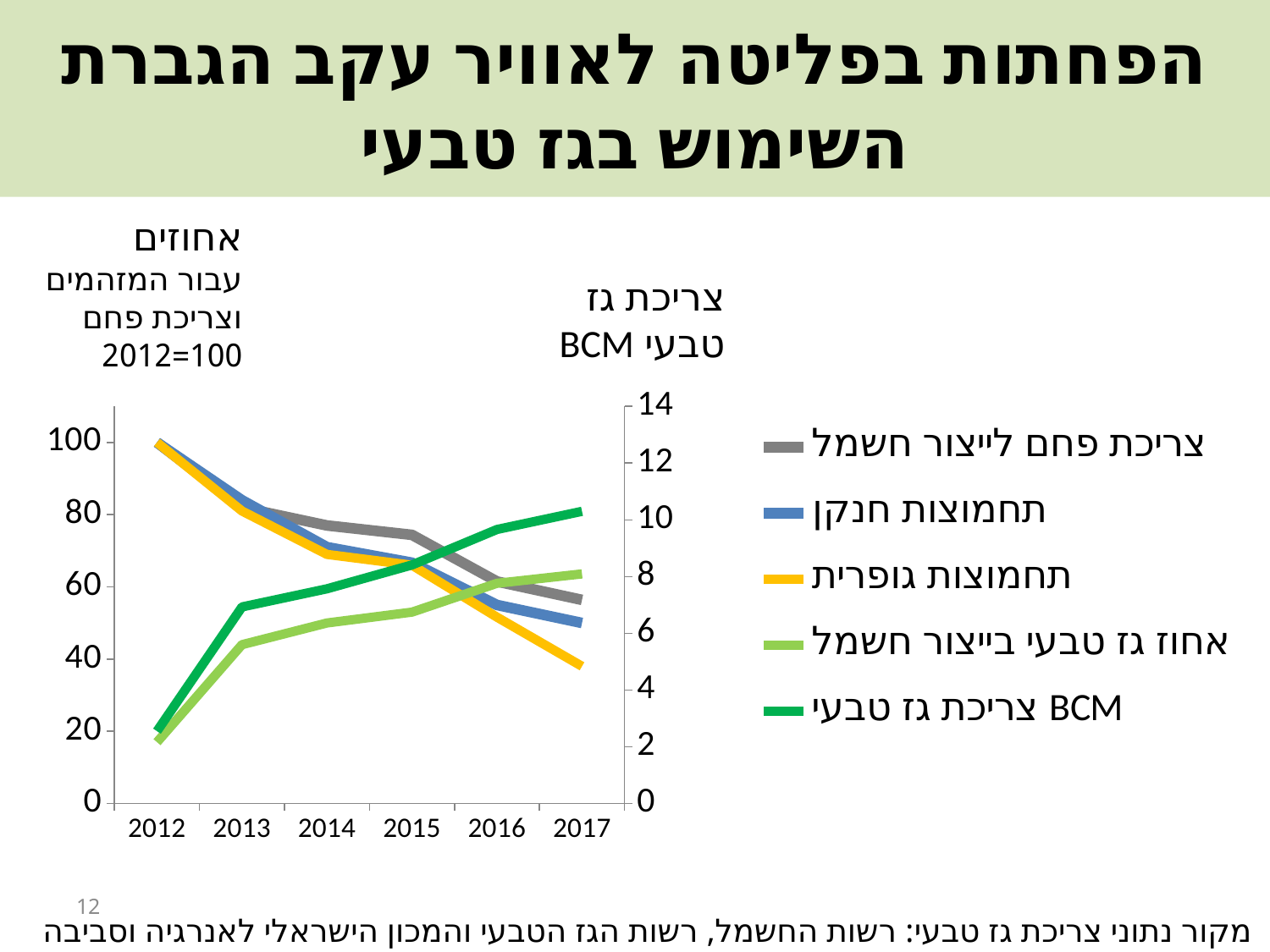
How many years are shown on the x axis? 6 In 2017, which is larger: צריכת פחם לייצור חשמל or תחמוצות גופרית? צריכת פחם לייצור חשמל In which year is the value for אחוז גז טבעי בייצור חשמל lowest? 2012 In which year is the value for תחמוצות גופרית lowest? 2017 Is the value for תחמוצות חנקן in 2017 greater or less than 60? less Which year is the first on the x axis? 2012 Is the value for צריכת גז טבעי BCM in 2017 greater or less than 8? greater In which year is the value for תחמוצות גופרית highest? 2012 What kind of chart is shown on the slide? line chart Does the line for תחמוצות גופרית rise or fall from 2012 to 2017? fall How many series does the legend list? 5 Does the line for אחוז גז טבעי בייצור חשמל rise or fall from 2012 to 2017? rise